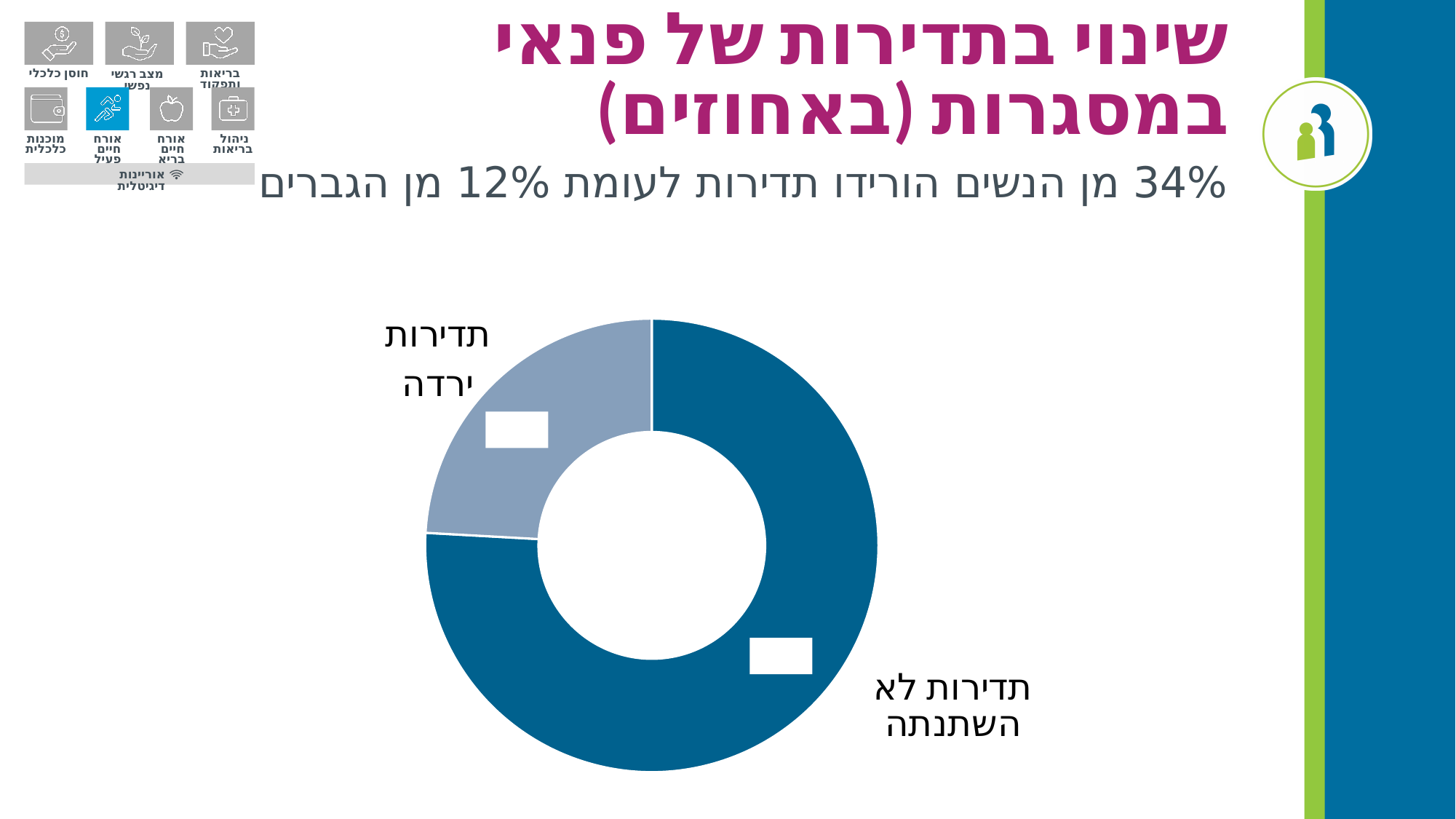
How many slices does the donut chart have? 2 Does the slice תדירות לא השתנתה take up more or less than half of the donut chart? more Which slice of the donut chart is the smallest? תדירות ירדה Which slice of the donut chart is the largest? תדירות לא השתנתה According to the subtitle text, what is the difference between the percentage of women and men who reduced their frequency? 22% What kind of chart is shown on the slide? Donut (pie) chart According to the subtitle text, what percentage of men reduced their frequency? 12% Which slice is larger: תדירות ירדה or תדירות לא השתנתה? תדירות לא השתנתה What colour is the slice labelled תדירות ירדה? Light grey-blue According to the subtitle text, what percentage of women reduced their frequency? 34% What is the title of the slide containing the chart? שינוי בתדירות של פנאי במסגרות (באחוזים)